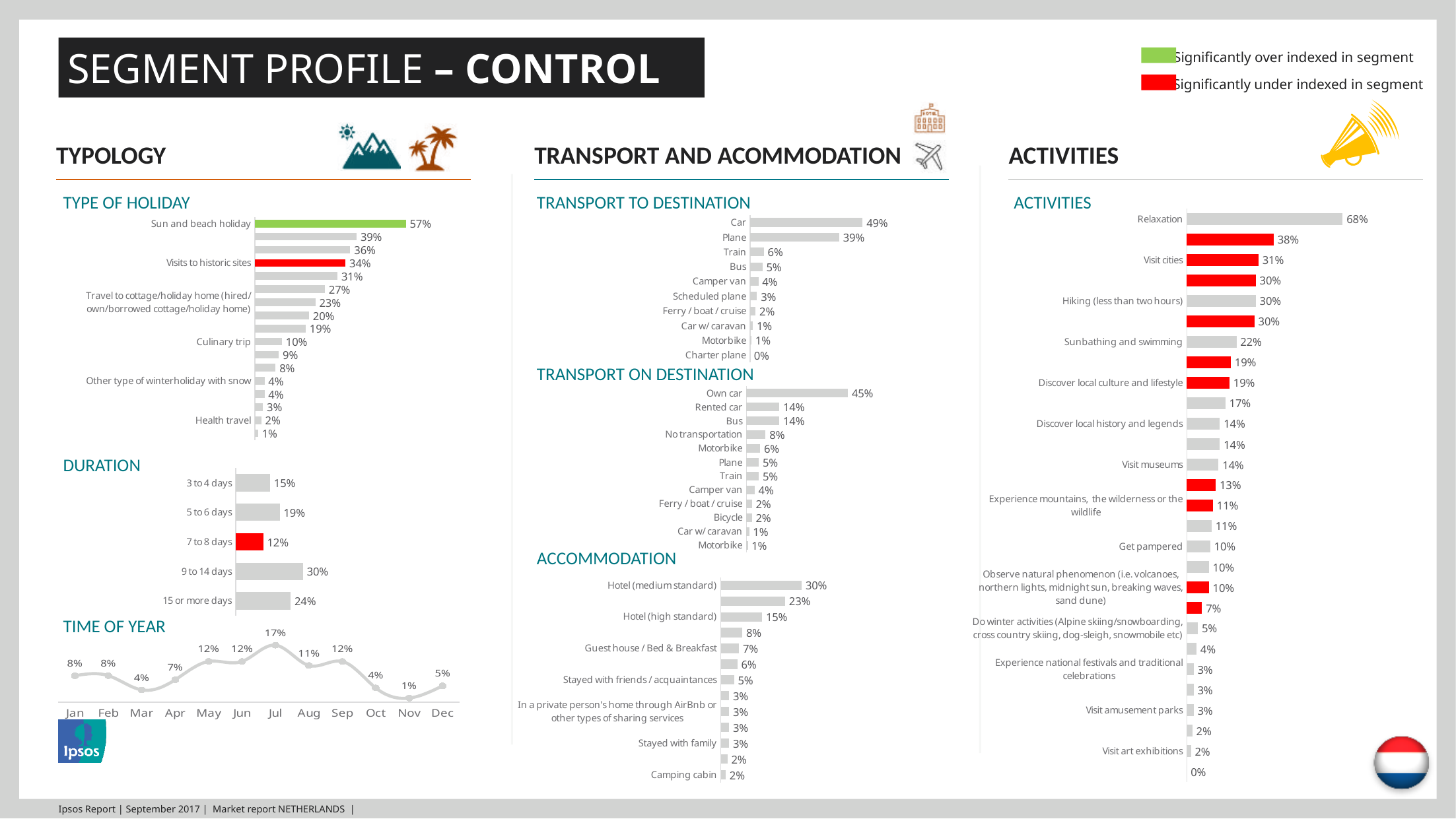
What type of chart is the Time of Year chart? line chart In the Transport on Destination chart, what is the value for Own car? 45% In the Time of Year chart, how many months are plotted? 12 In the Time of Year chart, what is the value for Nov? 1% In the Type of Holiday chart, what is the value for Sun and beach holiday? 57% In the Transport to Destination chart, what is the difference between Car and Plane? 10% In the Transport to Destination chart, what is the value for Plane? 39% In the Duration chart, what is the value for 9 to 14 days? 30% In the Time of Year chart, which month has the highest value? Jul In the Accommodation chart, which is larger, Hotel (medium standard) or Hotel (high standard)? Hotel (medium standard) In the Activities chart, what is the value for Relaxation? 68% In the Duration chart, which duration has the lowest value? 7 to 8 days